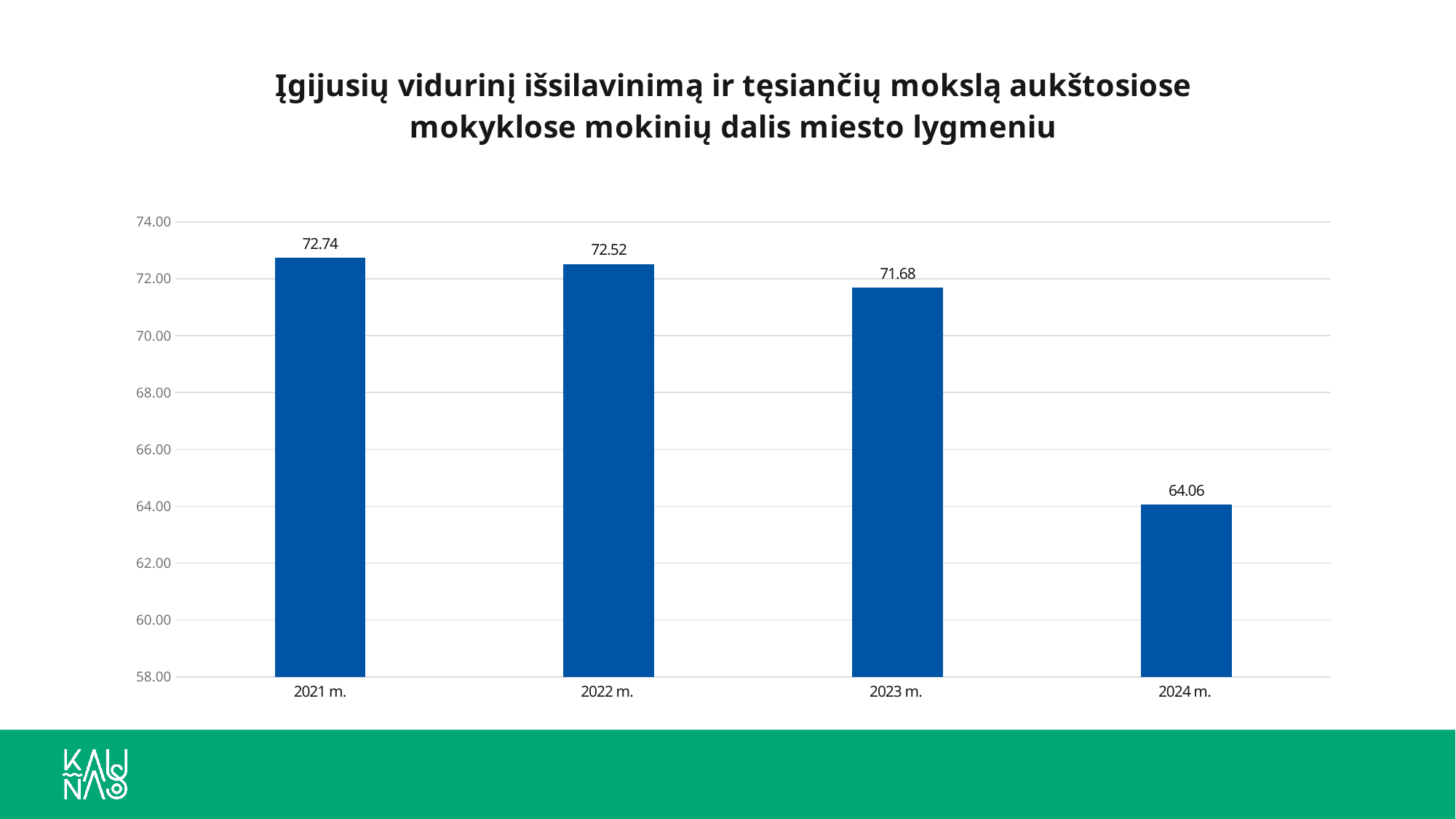
What is the value for 2023 m.? 71.68 What is the value for 2024 m.? 64.06 Is the value for 2024 m. greater or less than 66.00? less How many years are shown on the x axis? 4 What kind of chart is shown on the slide? bar chart What is the value for 2021 m.? 72.74 Which is larger, the value for 2022 m. or the value for 2024 m.? 2022 m. Which year has the highest value? 2021 m. Do the values rise or fall from 2021 m. to 2024 m.? fall What is the difference between the values for 2021 m. and 2022 m.? 0.22 What is the difference between the values for 2023 m. and 2024 m.? 7.62 Which year has the lowest value? 2024 m.